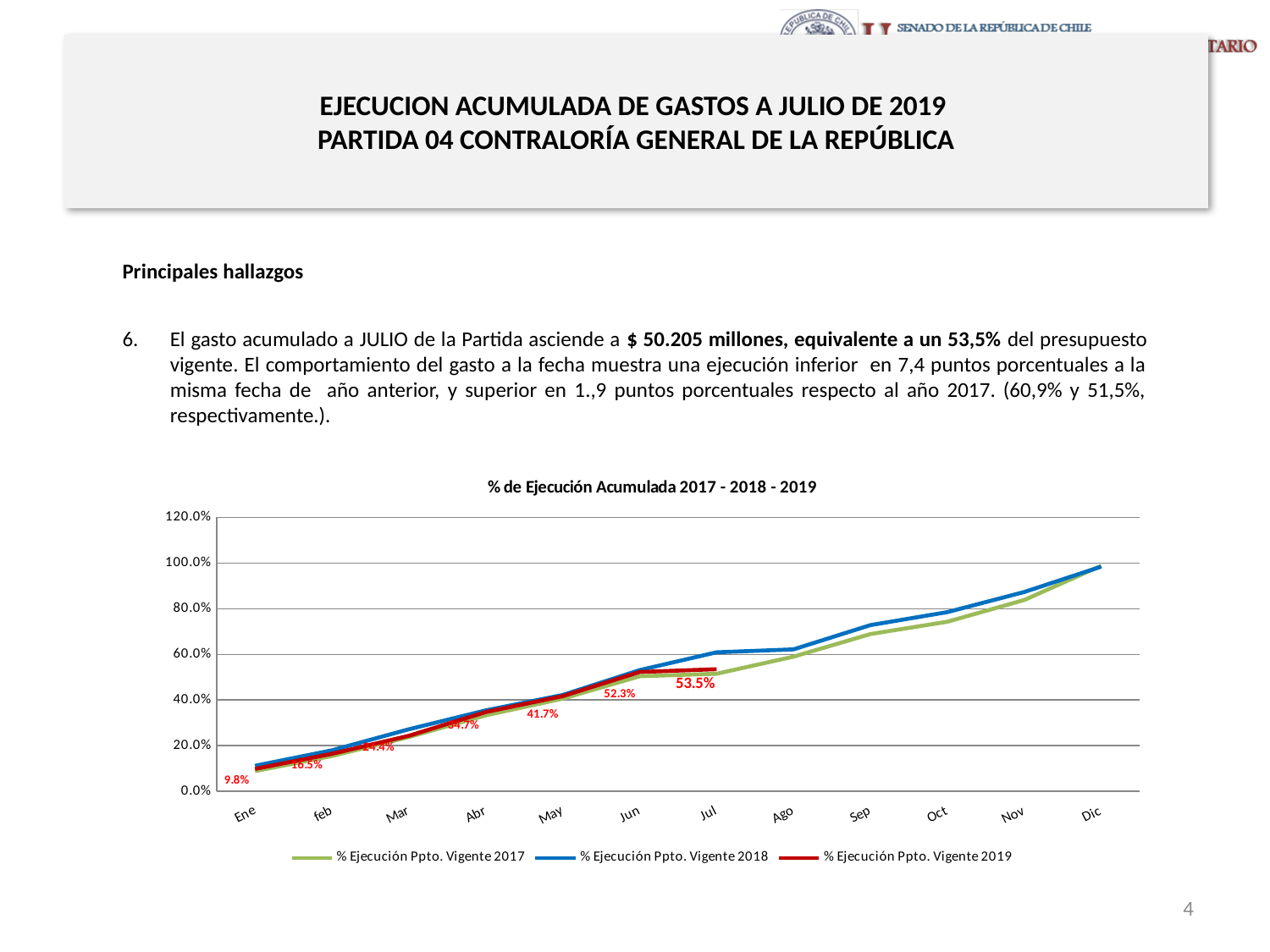
How many months are shown on the x axis of the chart? 12 What is the value of % Ejecución Ppto. Vigente 2019 for Ene? 9.8% By how many percentage points did % Ejecución Ppto. Vigente 2019 increase from Jun to Jul? 1.2 What is the value of % Ejecución Ppto. Vigente 2019 for Jul? 53.5% What is the value of % Ejecución Ppto. Vigente 2019 for Jun? 52.3% What is the title of the chart? % de Ejecución Acumulada 2017 - 2018 - 2019 What kind of chart is shown on the slide? line chart Is the value for % Ejecución Ppto. Vigente 2018 in Dic greater or less than 80.0%? greater What is the value of % Ejecución Ppto. Vigente 2019 for feb? 16.5% What is the value of % Ejecución Ppto. Vigente 2019 for May? 41.7% Do the values of % Ejecución Ppto. Vigente 2018 rise or fall from Ene to Dic? rise How many series does the legend of the chart list? 3